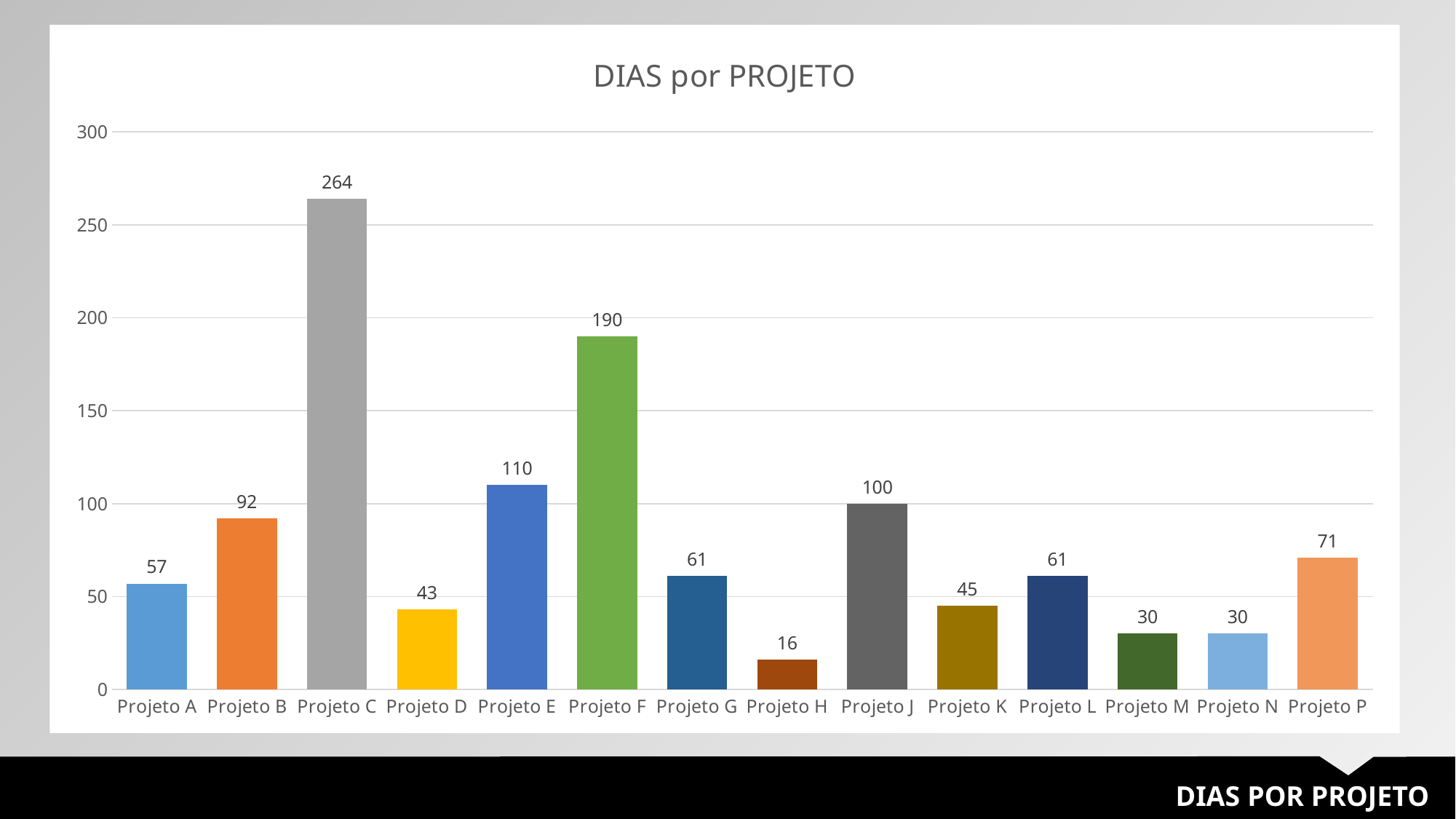
What is the title of the chart? DIAS por PROJETO What is the value for Projeto K? 45 How many projects are shown on the x axis? 14 What is the difference between the values for Projeto C and Projeto F? 74 What is the value for Projeto H? 16 Is the value for Projeto F greater or less than 150? greater Which is larger, the value for Projeto B or the value for Projeto P? Projeto B Which project has the highest value? Projeto C What kind of chart is shown on the slide? Bar chart What is the difference between the values for Projeto E and Projeto J? 10 Which project has the lowest value? Projeto H What is the value for Projeto C? 264